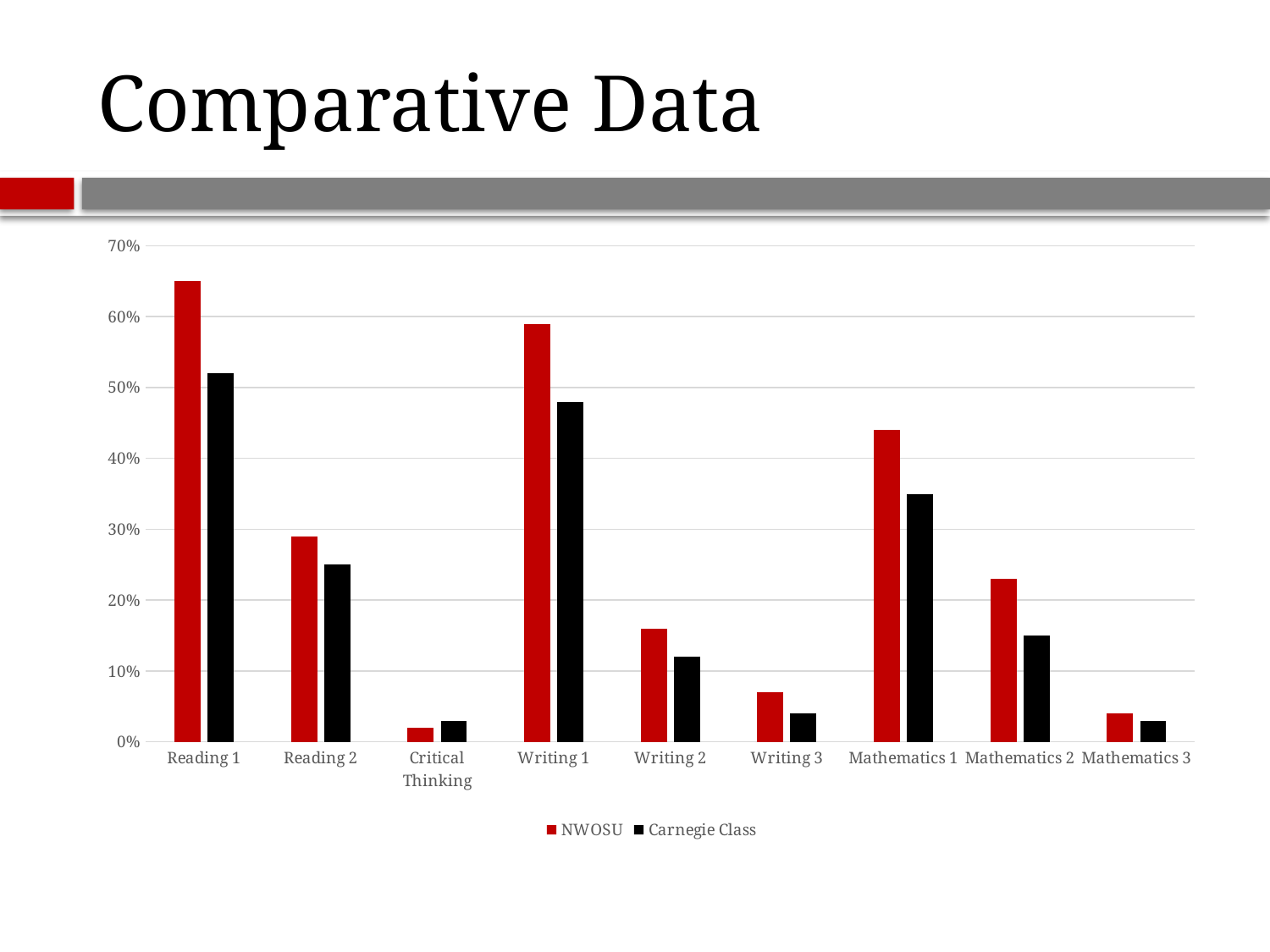
How many series does the legend list? 2 Which category has the highest Carnegie Class value? Reading 1 How many categories are shown on the x axis? 9 Which series is shown in red in the legend? NWOSU Which NWOSU value is larger: Writing 1 or Mathematics 1? Writing 1 Is the NWOSU value for Reading 1 greater or less than 60%? greater Is the Carnegie Class value for Writing 1 greater or less than 50%? less Which category has the highest NWOSU value? Reading 1 Is the NWOSU value for Mathematics 1 greater or less than 40%? greater For Reading 1, which is larger: the NWOSU value or the Carnegie Class value? NWOSU Which category has the lowest NWOSU value? Critical Thinking What kind of chart is shown on the slide? bar chart